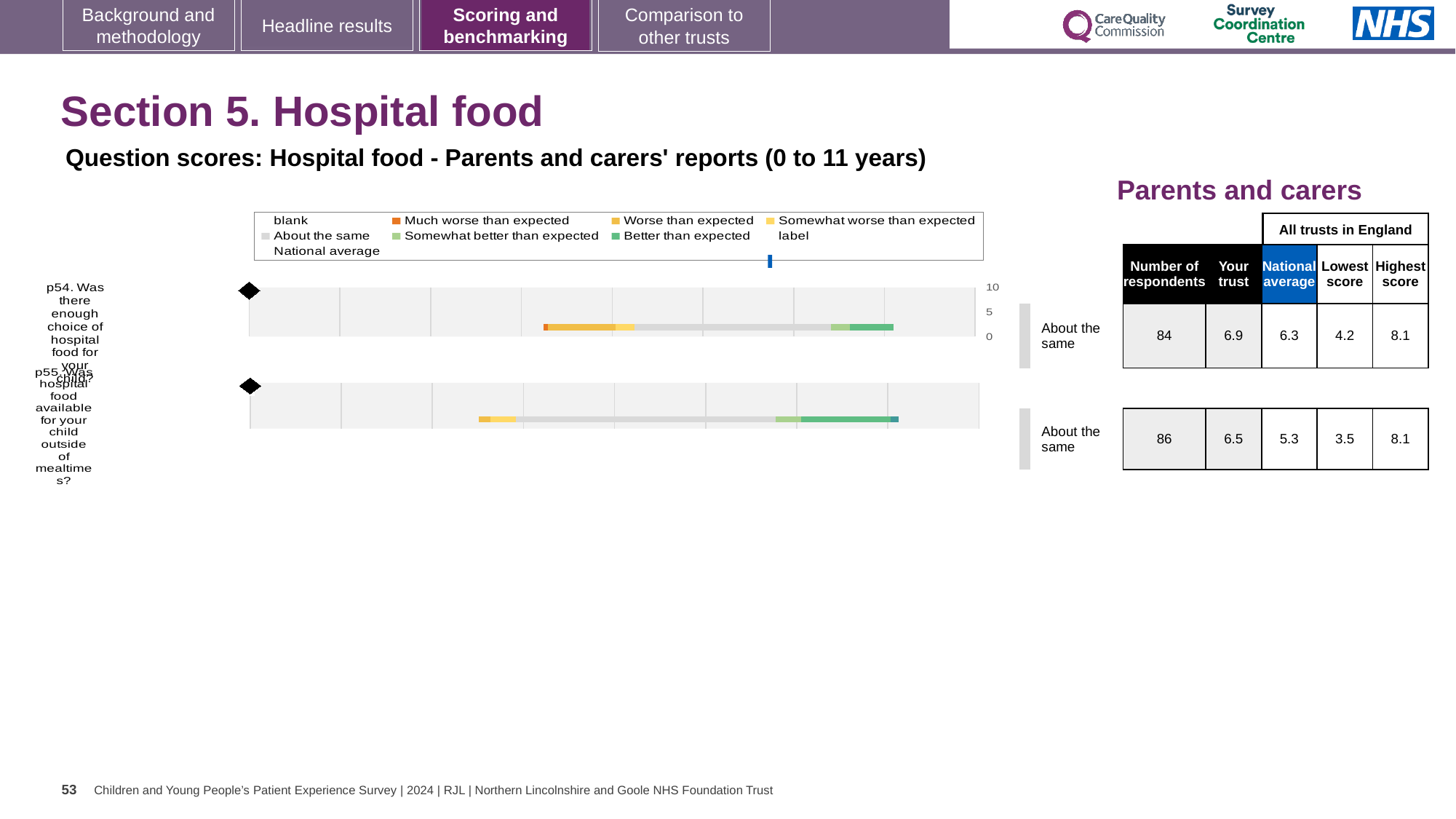
What is the national average score for p55? 5.3 What is the 'Your trust' score for p54 (Was there enough choice of hospital food for your child?)? 6.9 How is the trust's result for p55 categorised relative to expectations? About the same How many respondents answered p54? 84 What is the highest value shown on the score axis of the chart? 10 What is the difference between the trust's score and the national average for p54? 0.6 What is the highest score across all trusts in England for p55? 8.1 Which question has the higher 'Your trust' score, p54 or p55? p54 What is the 'Your trust' score for p55 (Was hospital food available for your child outside of mealtimes?)? 6.5 How many survey questions (bars) are plotted in the hospital food chart? 2 What is the lowest score across all trusts in England for p54? 4.2 What kind of chart is used to show the question scores for hospital food? bar chart